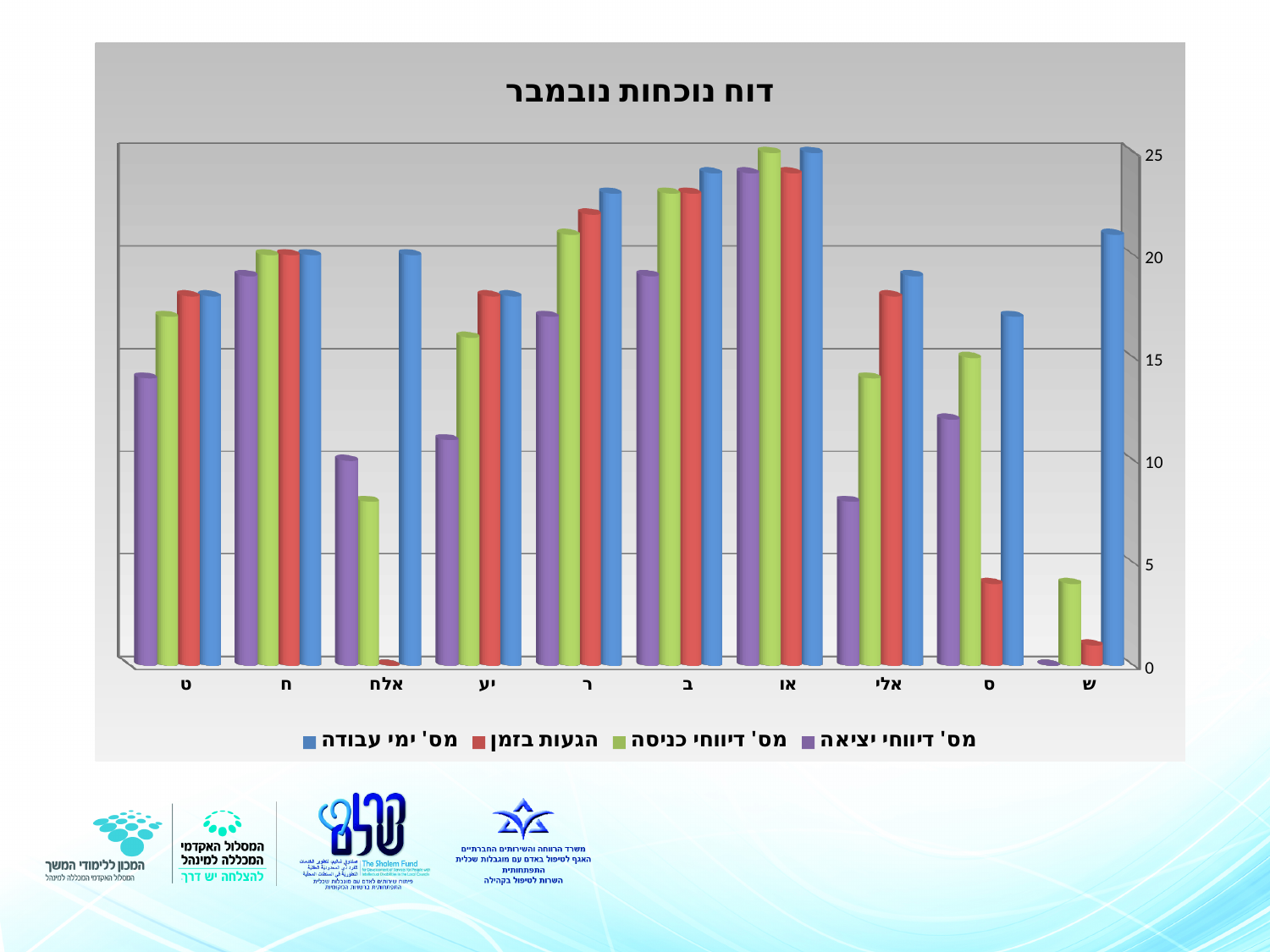
Is the value of מס' ימי עבודה for אלח greater or less than 15? greater Which category has the lowest value of מס' דיווחי כניסה? ש What is the title of the chart? דוח נוכחות נובמבר How many categories are shown on the x axis? 10 For category ס, which is larger: מס' ימי עבודה or הגעות בזמן? מס' ימי עבודה What kind of chart is shown on the slide? bar chart Which colour represents מס' ימי עבודה in the legend? blue Is the value of מס' דיווחי כניסה for ס greater or less than 10? greater Which category has the highest value of מס' דיווחי יציאה? או Is the value of הגעות בזמן for ש greater or less than 5? less How many series does the legend list? 4